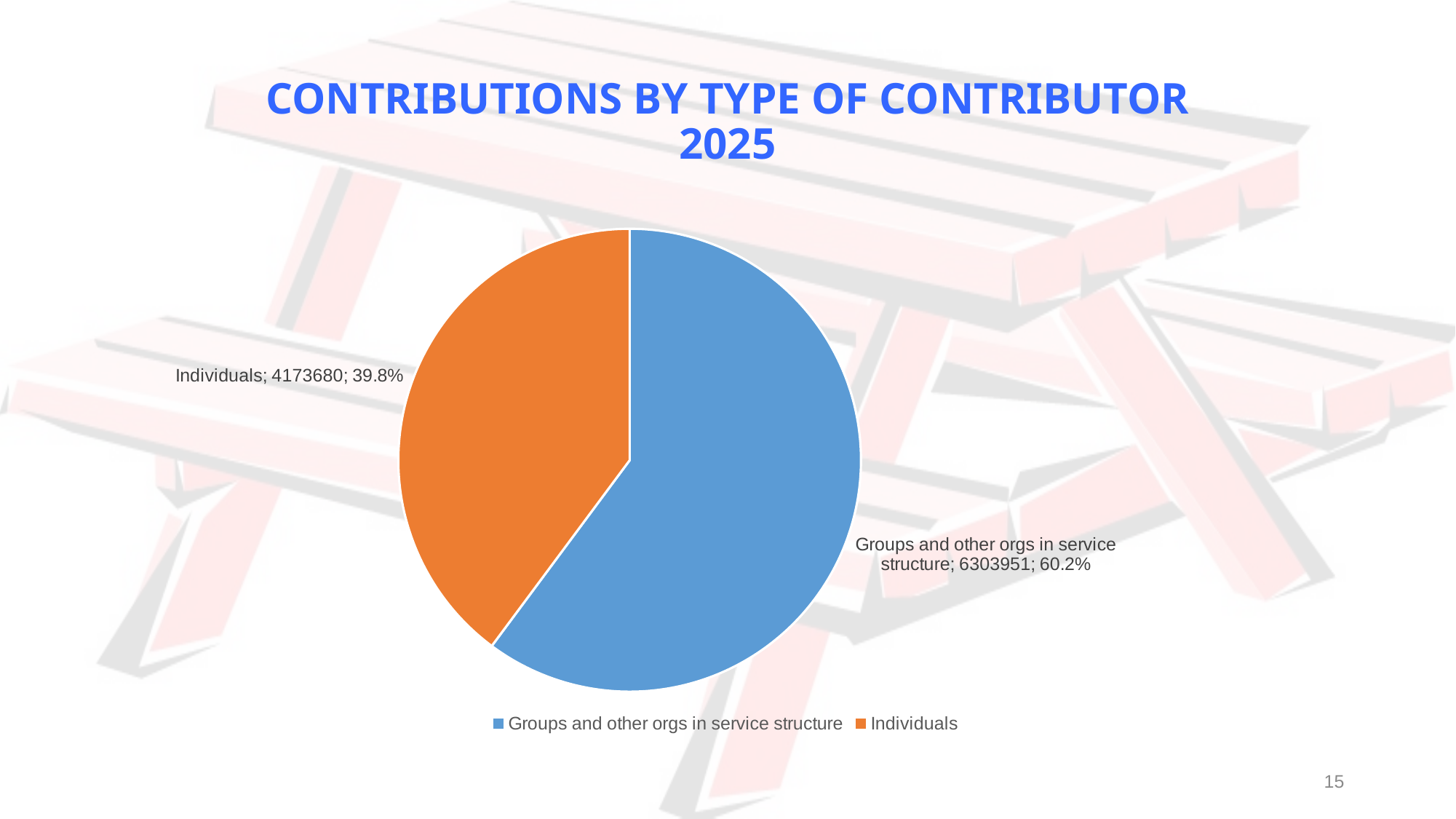
Which is larger, the contribution from Individuals or from Groups and other orgs in service structure? Groups and other orgs in service structure What is the difference between the contributions of Groups and other orgs in service structure and Individuals? 2130271 What is the contribution value for Groups and other orgs in service structure? 6303951 Which type of contributor has the largest contribution? Groups and other orgs in service structure How many slices does the pie chart have? 2 What share of the pie does the Individuals slice represent? 39.8% What is the title of the chart? CONTRIBUTIONS BY TYPE OF CONTRIBUTOR 2025 What kind of chart is shown on the slide? pie chart What is the total of the two contribution values shown? 10477631 Which type of contributor has the smallest contribution? Individuals What is the contribution value for Individuals? 4173680 What share of the pie does the Groups and other orgs in service structure slice represent? 60.2%